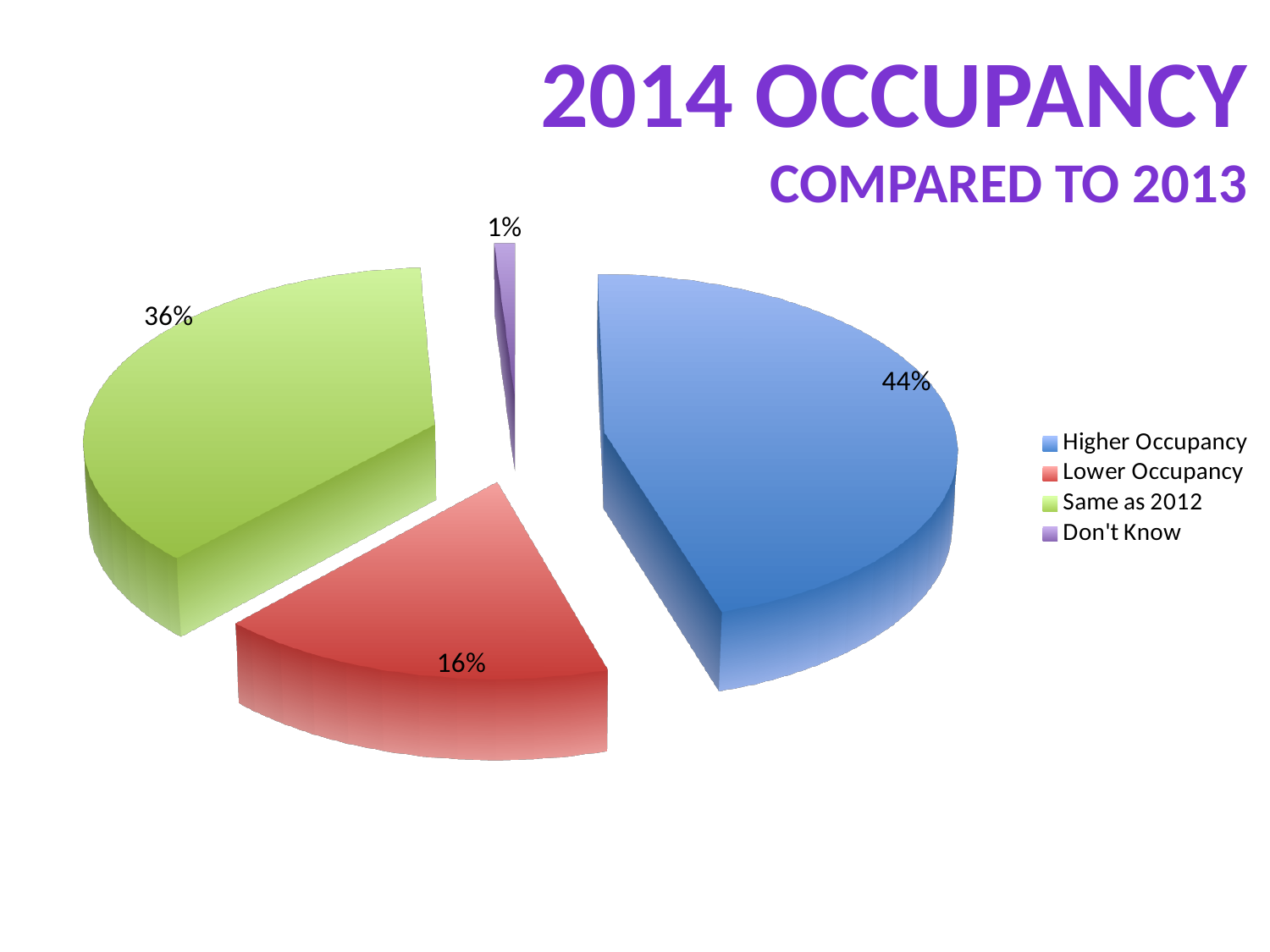
Which category has the smallest slice of the pie? Don't Know What is the difference between the Higher Occupancy and Lower Occupancy shares? 28% What is the difference between the Same as 2012 and Lower Occupancy shares? 20% Which category has the largest slice of the pie? Higher Occupancy What share of the pie is Don't Know? 1% What colour is the Lower Occupancy slice? Red How many categories does the legend list? 4 What share of the pie is Same as 2012? 36% What share of the pie is Higher Occupancy? 44% Which is larger, the Same as 2012 slice or the Lower Occupancy slice? Same as 2012 What kind of chart is shown on the slide? Pie chart